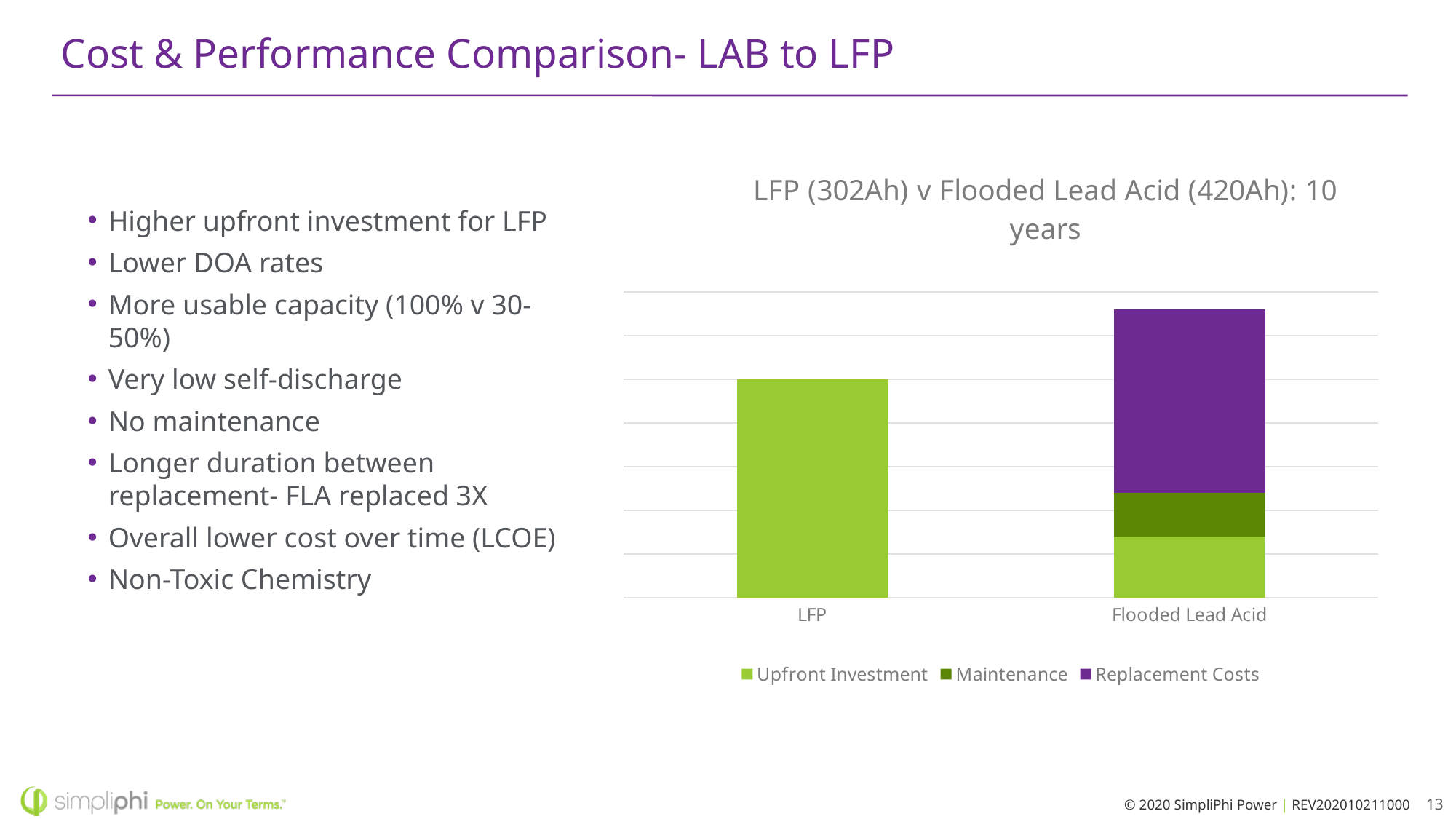
Which category has the larger Upfront Investment segment, LFP or Flooded Lead Acid? LFP How many categories are shown on the x axis of the chart? 2 Which series makes up the largest segment of the Flooded Lead Acid bar? Replacement Costs What is the title of the chart? LFP (302Ah) v Flooded Lead Acid (420Ah): 10 years What kind of chart is shown on the slide? Stacked bar chart How many series does the chart legend list? 3 Which series is the only one shown in the LFP bar? Upfront Investment Which series are listed in the chart legend? Upfront Investment, Maintenance, Replacement Costs Which category has the shorter total stacked bar? LFP Which series makes up the smallest segment of the Flooded Lead Acid bar? Maintenance Is the Replacement Costs segment for Flooded Lead Acid larger or smaller than its Maintenance segment? Larger Which category has the taller total stacked bar, LFP or Flooded Lead Acid? Flooded Lead Acid